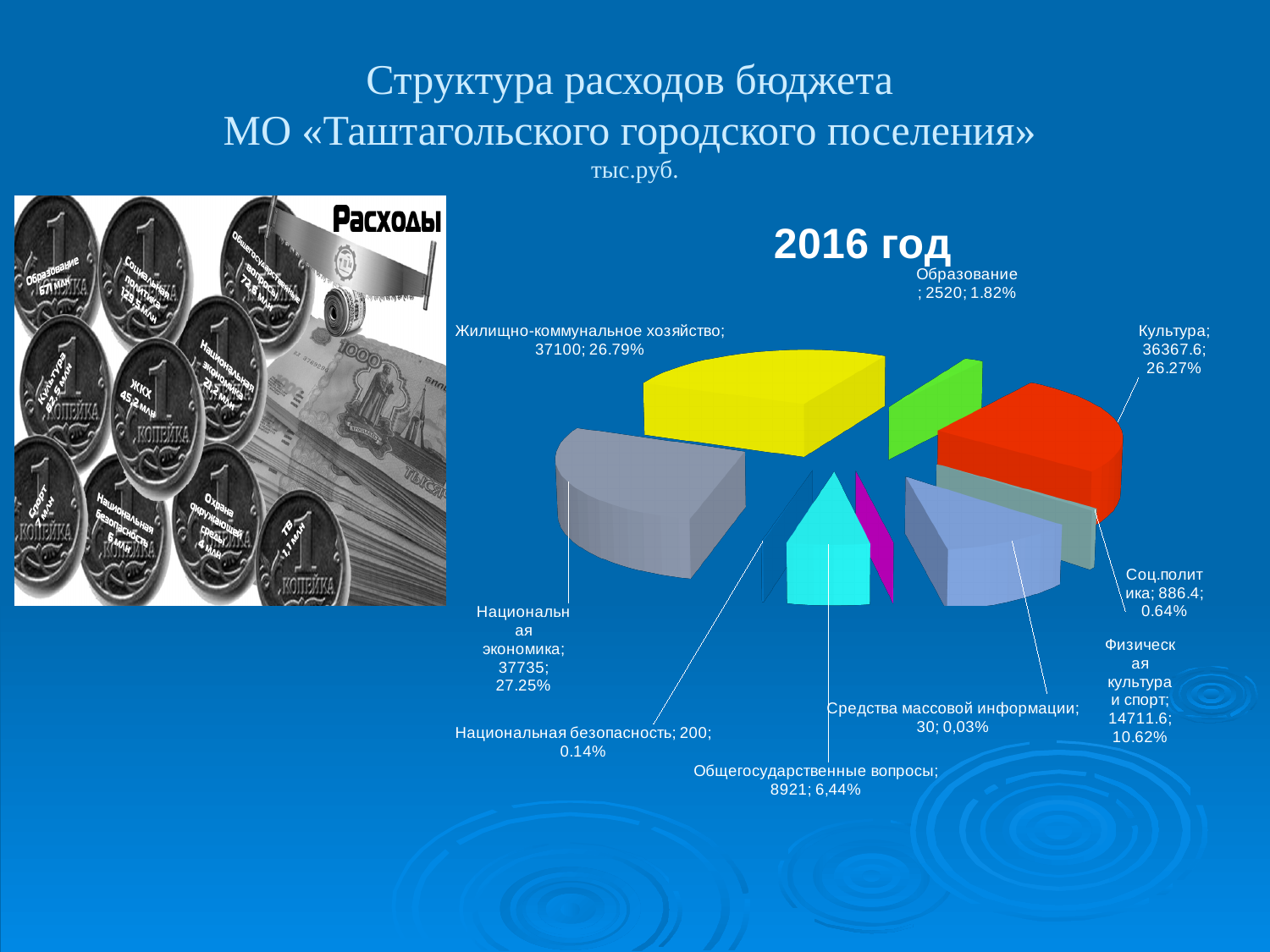
Which category has the smallest value? Средства массовой информации What is the value for Жилищно-коммунальное хозяйство? 37100 What is the chart's title? 2016 год What is the value for Национальная безопасность? 200 Which is larger: the value for Общегосударственные вопросы or the value for Соц.политика? Общегосударственные вопросы How many categories (slices) does the pie chart have? 9 What type of chart is shown on the slide? pie chart What share of the pie does Культура represent? 26.27% What percentage is shown for Образование? 1.82% What is the value for Физическая культура и спорт? 14711.6 What is the difference between the values for Национальная экономика and Жилищно-коммунальное хозяйство? 635 Which category has the largest value? Национальная экономика